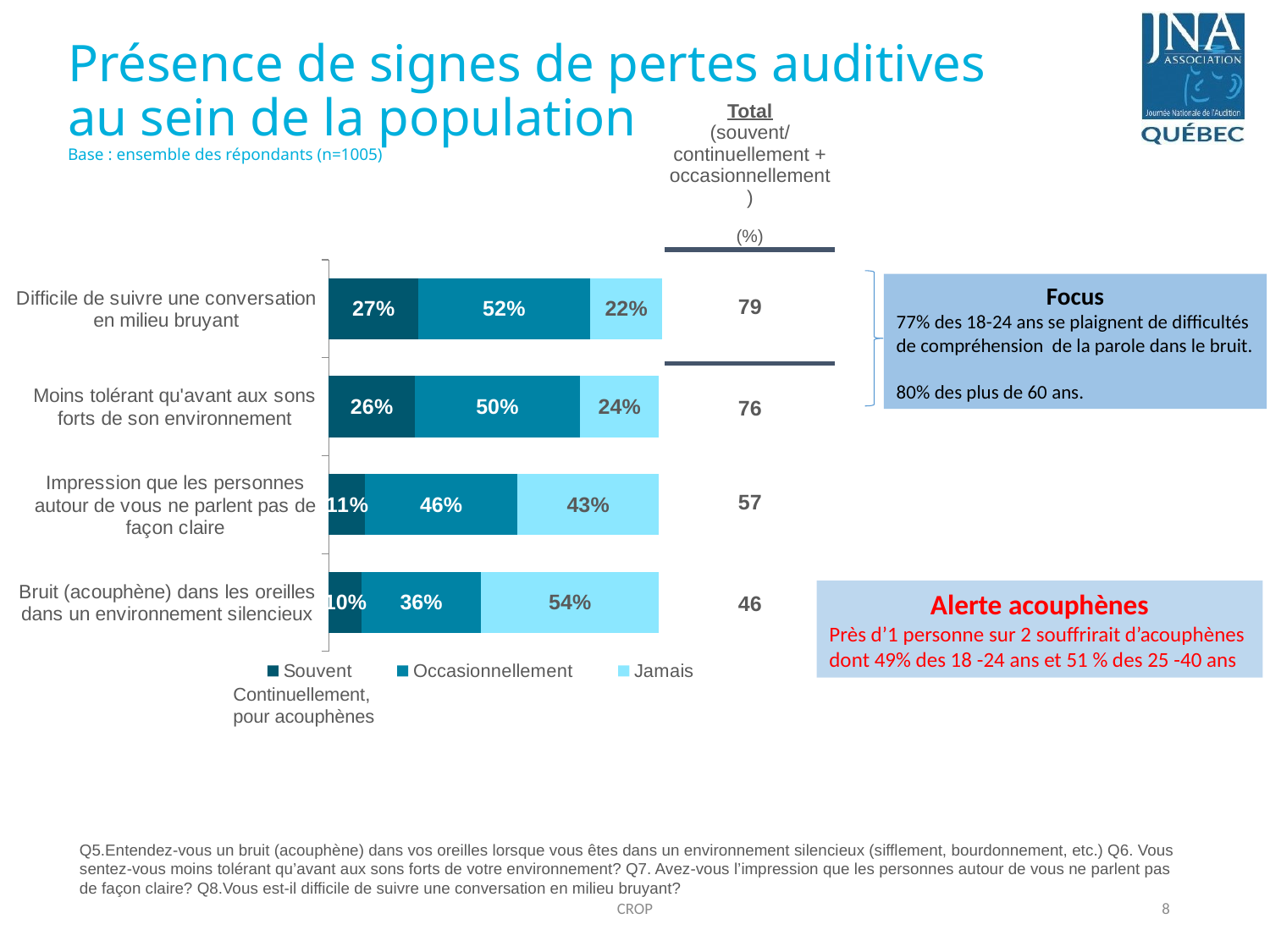
Which category has the lowest 'Souvent / Continuellement' value? Bruit (acouphène) dans les oreilles dans un environnement silencieux Which legend entry is shown in the lightest blue colour? Jamais What is the 'Souvent / Continuellement' value for 'Moins tolérant qu'avant aux sons forts de son environnement'? 26% How many series does the chart legend list? 3 How many categories (signs of hearing loss) are plotted in the chart? 4 Which category has the highest 'Jamais' value? Bruit (acouphène) dans les oreilles dans un environnement silencieux What kind of chart is shown on the slide? stacked bar chart What is the 'Jamais' value for 'Bruit (acouphène) dans les oreilles dans un environnement silencieux'? 54% What is the 'Occasionnellement' value for 'Difficile de suivre une conversation en milieu bruyant'? 52% What is the Total (souvent/continuellement + occasionnellement) shown for 'Impression que les personnes autour de vous ne parlent pas de façon claire'? 57 What is the difference between the 'Occasionnellement' values for 'Difficile de suivre une conversation en milieu bruyant' and 'Bruit (acouphène) dans les oreilles dans un environnement silencieux'? 16% Which is larger: the 'Jamais' value for 'Moins tolérant qu'avant aux sons forts de son environnement' or the 'Jamais' value for 'Impression que les personnes autour de vous ne parlent pas de façon claire'? Impression que les personnes autour de vous ne parlent pas de façon claire